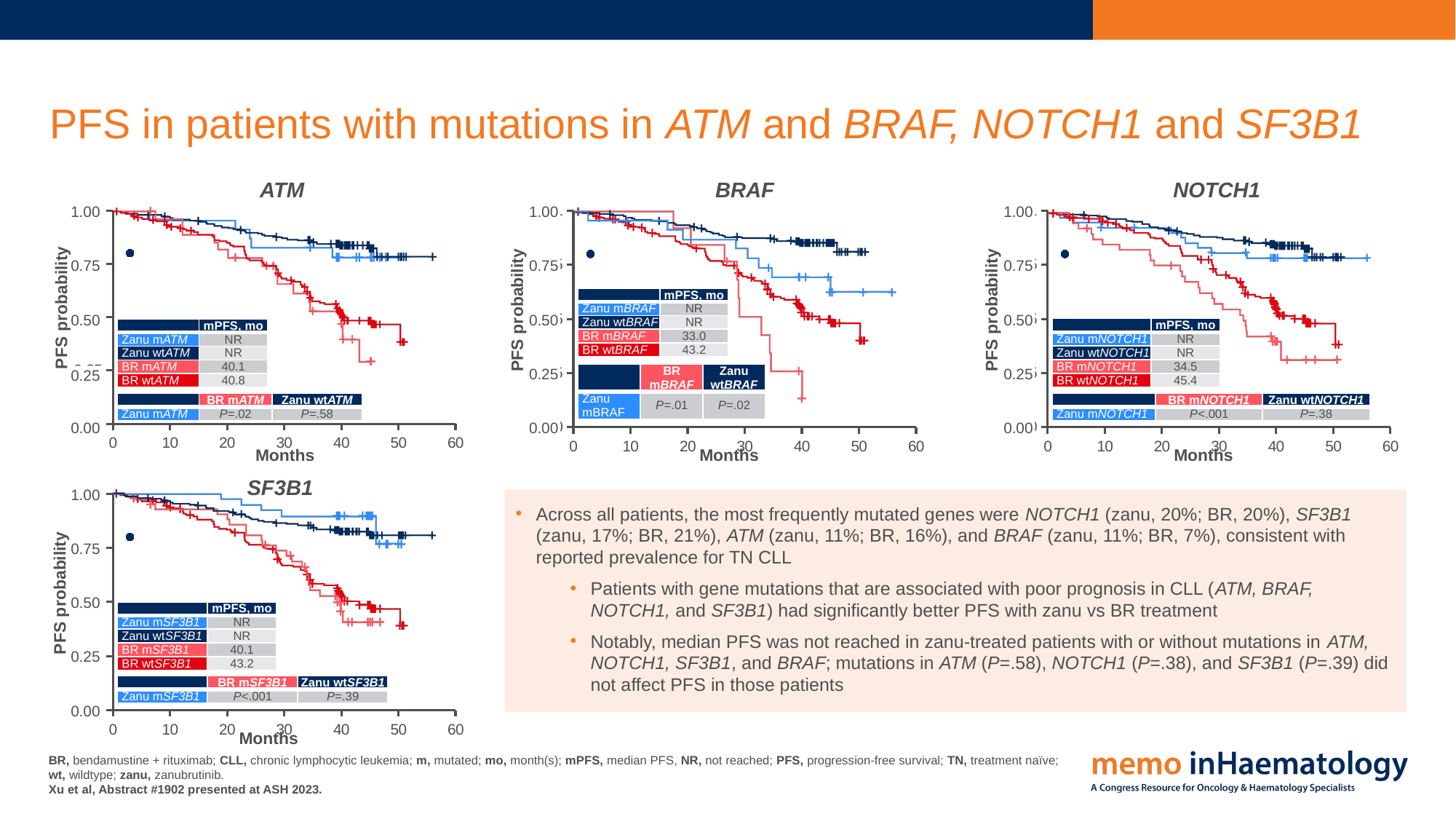
In the SF3B1 chart, which has the longer median PFS, BR mSF3B1 or BR wtSF3B1? BR wtSF3B1 In the NOTCH1 chart, what is the median PFS in months for BR wtNOTCH1? 45.4 In the ATM chart, what is the P value for Zanu mATM versus Zanu wtATM? P=.58 In the BRAF chart, do the PFS probability curves rise or fall as months increase? Fall What kind of chart is the SF3B1 chart? Line chart (Kaplan-Meier survival curve) In the ATM chart, which BR group has the lower median PFS, BR mATM or BR wtATM? BR mATM In the BRAF chart, what is the difference in median PFS (months) between BR wtBRAF and BR mBRAF? 10.2 How many patient groups (curves) are plotted in the NOTCH1 chart? 4 In the ATM chart, what is the median PFS for Zanu mATM? NR In the BRAF chart, what is the median PFS in months for BR mBRAF? 33.0 In the SF3B1 chart, what is the P value for Zanu mSF3B1 versus BR mSF3B1? P<.001 In the NOTCH1 chart, what is the difference in median PFS (months) between BR wtNOTCH1 and BR mNOTCH1? 10.9